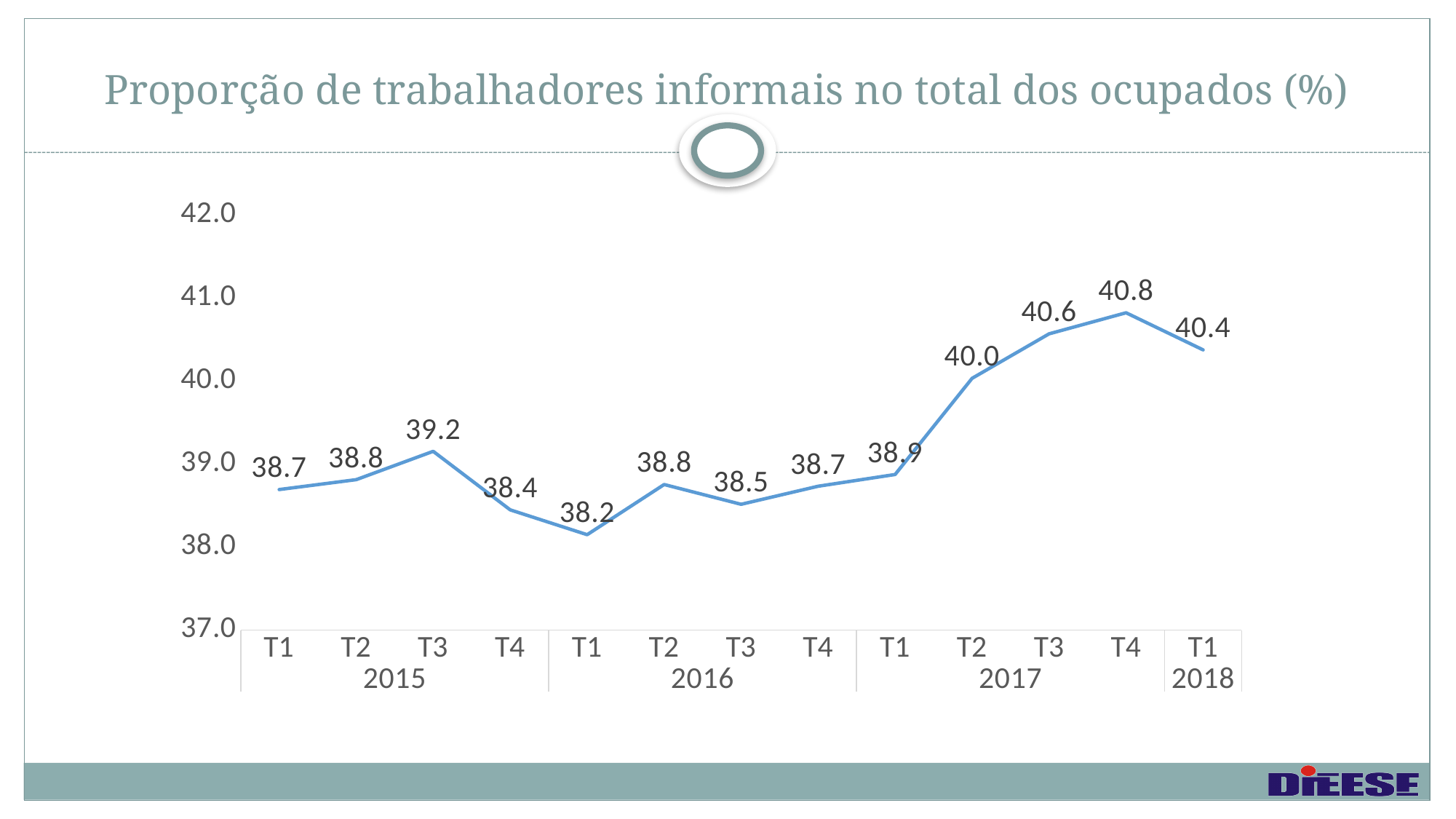
Which quarter has the highest value? T4 2017 What is the value for T4 2017? 40.8 Which is larger, the value for T2 2017 or the value for T3 2016? T2 2017 What is the value for T3 2015? 39.2 What kind of chart is shown on the slide? line chart What is the difference between the values for T4 2017 and T1 2016? 2.6 Do the values rise or fall from T1 2017 to T4 2017? rise What is the value for T1 2018? 40.4 What is the value for T1 2016? 38.2 How many data points are plotted on the chart? 13 Is the value for T3 2017 greater or less than 40.0? greater Which quarter has the lowest value? T1 2016